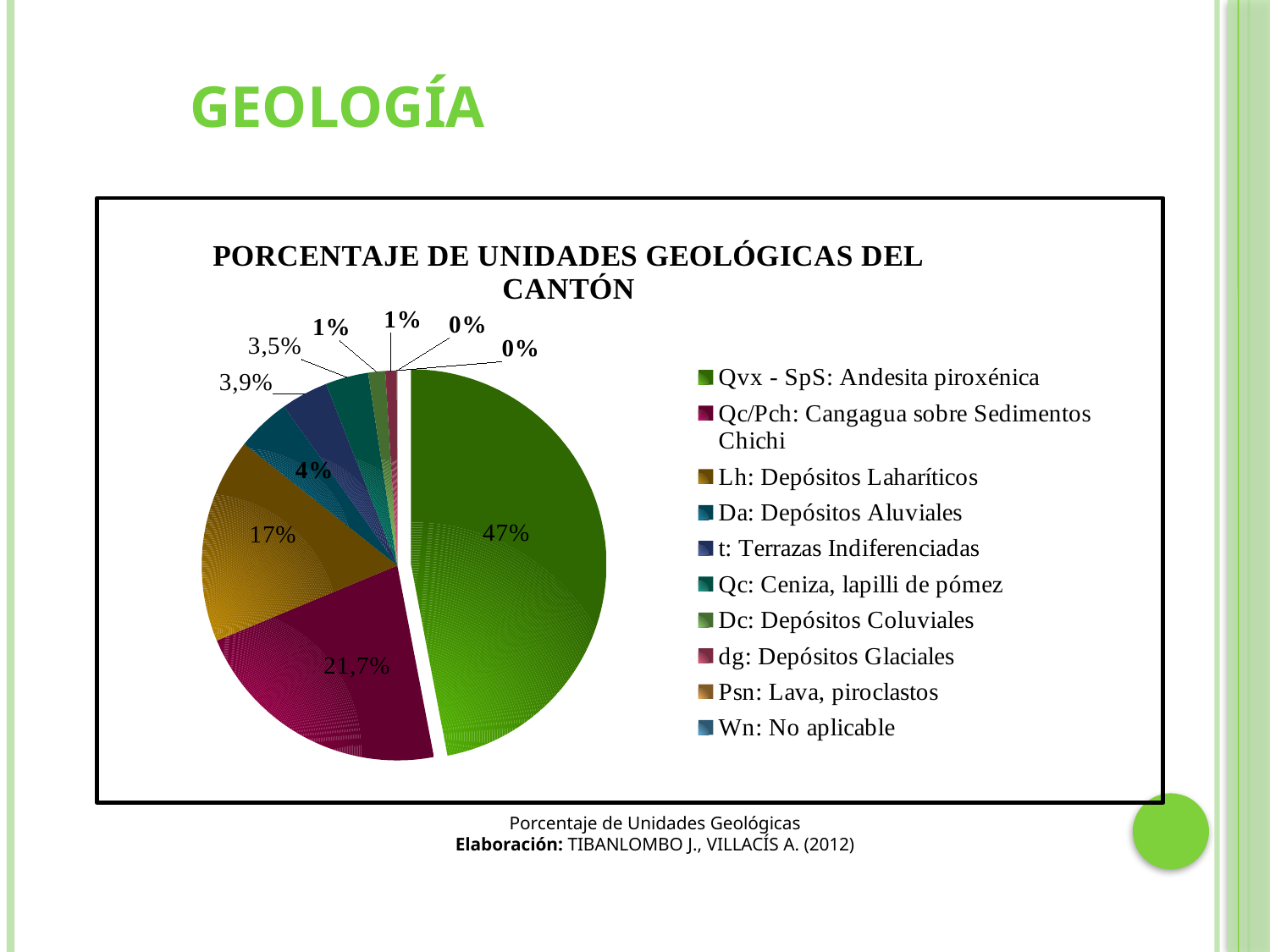
Is the share for Qvx - SpS: Andesita piroxénica greater or less than 50%? less What percentage is shown for Qvx - SpS: Andesita piroxénica? 47% How many entries does the chart legend list? 10 What is the title of the chart? PORCENTAJE DE UNIDADES GEOLÓGICAS DEL CANTÓN What kind of chart is shown on the slide? pie chart What is the combined share of the three largest slices (Qvx - SpS, Qc/Pch and Lh)? 85,7% What percentage is shown for Qc/Pch: Cangagua sobre Sedimentos Chichi? 21,7% Which has a larger share, Lh: Depósitos Laharíticos or Qc/Pch: Cangagua sobre Sedimentos Chichi? Qc/Pch: Cangagua sobre Sedimentos Chichi Which geological unit has the largest share of the pie? Qvx - SpS: Andesita piroxénica What percentage is shown for Lh: Depósitos Laharíticos? 17% What is the difference between the shares of Qvx - SpS: Andesita piroxénica and Qc/Pch: Cangagua sobre Sedimentos Chichi? 25,3% How many slices are labelled 0%? 2